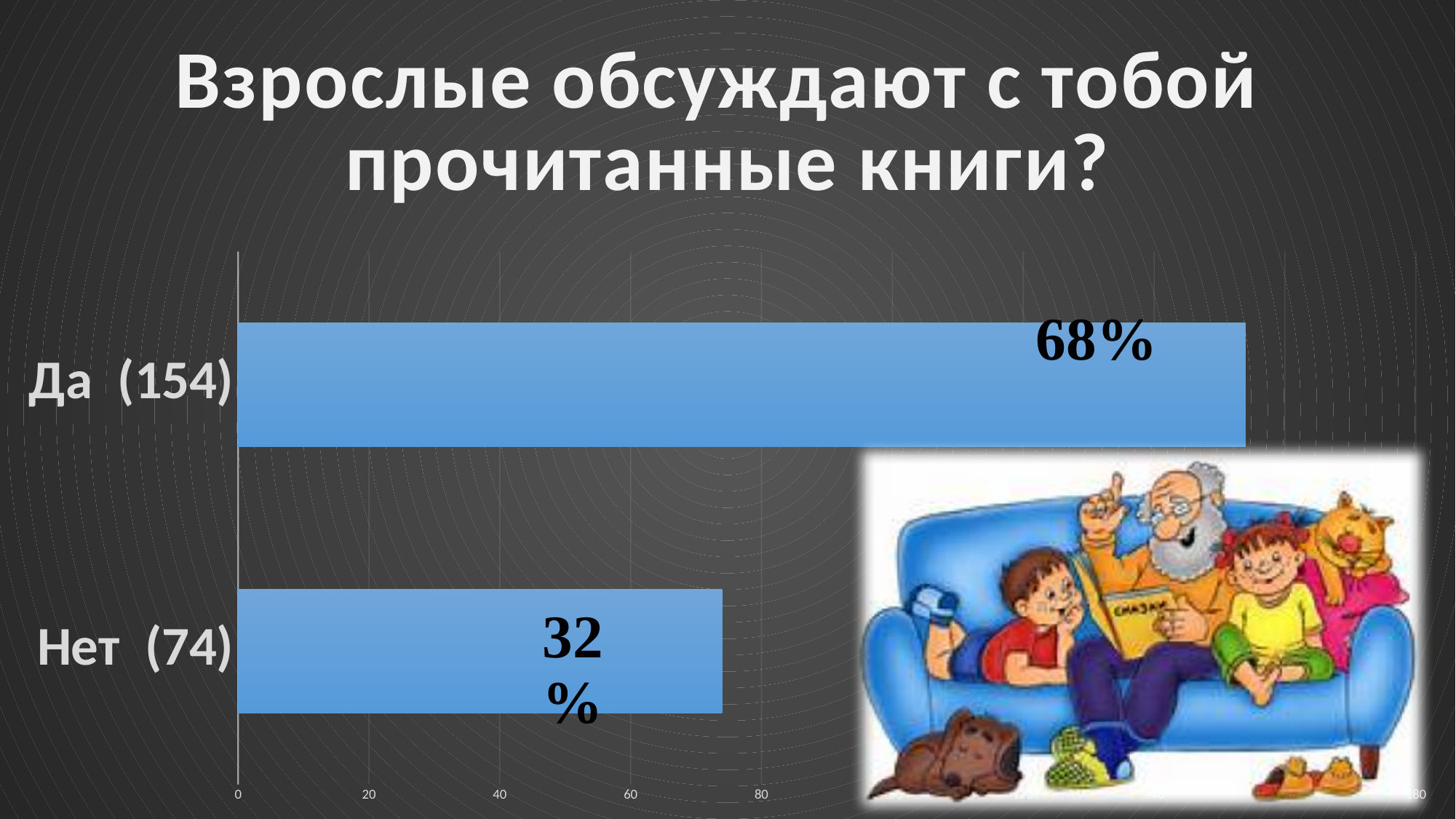
Which bar is longer, "Да" or "Нет"? Да What type of chart is shown on the slide? Bar chart Is the bar for "Да (154)" greater or less than 140 on the axis? greater What is the difference in percentage points between the "Да" label (68%) and the "Нет" label (32%)? 36 Which category has the longest bar? Да (154) How many categories are shown in the chart? 2 What is the data label shown on the bar for "Да (154)"? 68% Which category has the shortest bar? Нет (74) What number is shown in parentheses next to the category "Нет"? 74 What is the data label shown on the bar for "Нет (74)"? 32% What is the title of the slide? Взрослые обсуждают с тобой прочитанные книги? Is the bar for "Нет (74)" greater or less than 80 on the axis? less